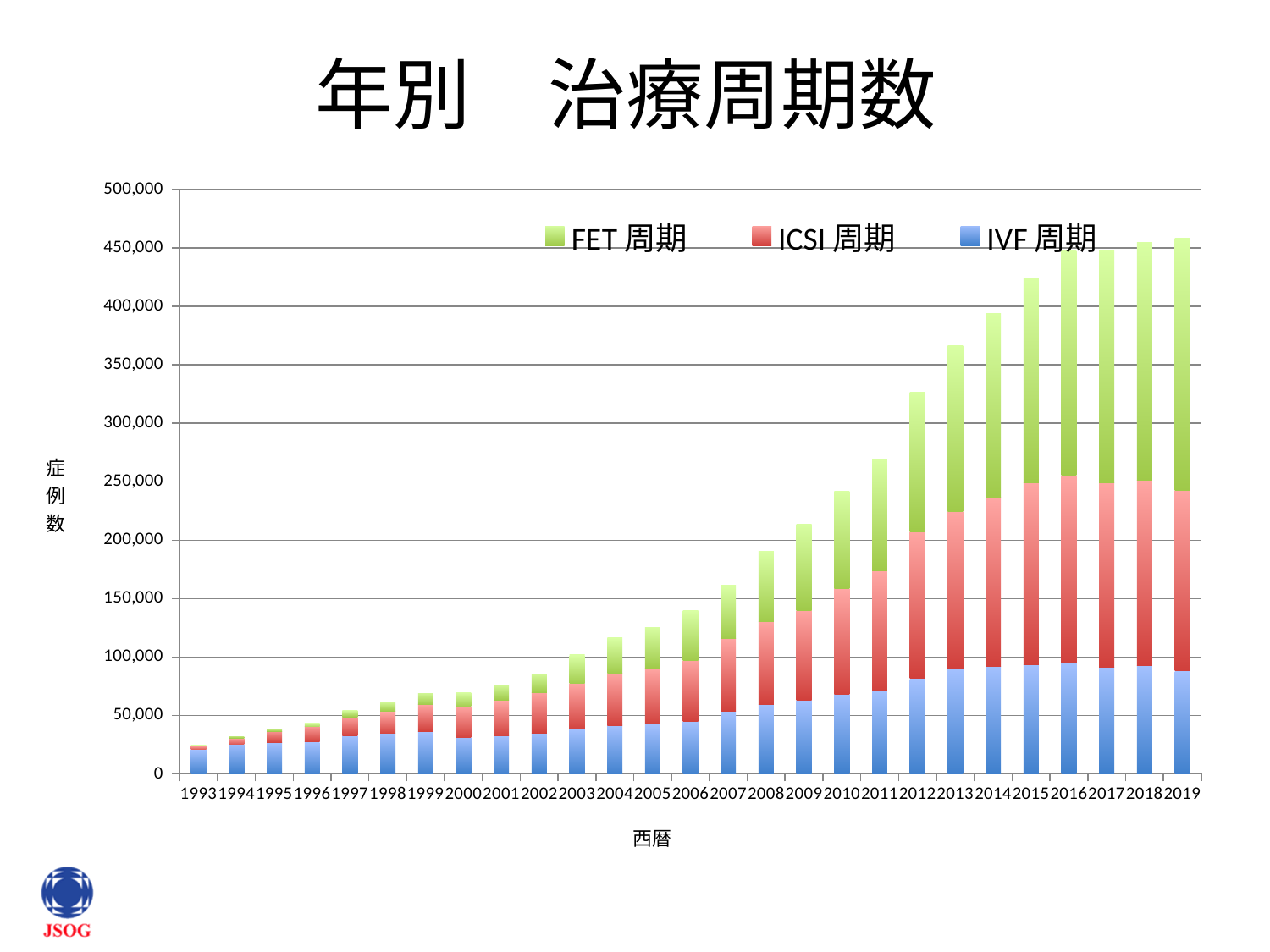
Is the total value for 2019 greater or less than 450,000? greater Which year has the lowest total number of treatment cycles? 1993 Is the total value for 2012 greater or less than 300,000? greater What is the title of the chart? 年別 治療周期数 Is the total value for 2013 greater or less than 350,000? greater Do the total treatment cycles generally rise or fall from 1993 to 2019? rise How many years are shown along the x axis of the chart? 27 Which series is shown in green in the chart's legend? FET 周期 How many series does the chart's legend list? 3 Which year has the larger total number of treatment cycles, 2005 or 2010? 2010 What kind of chart is shown on the slide? stacked bar chart